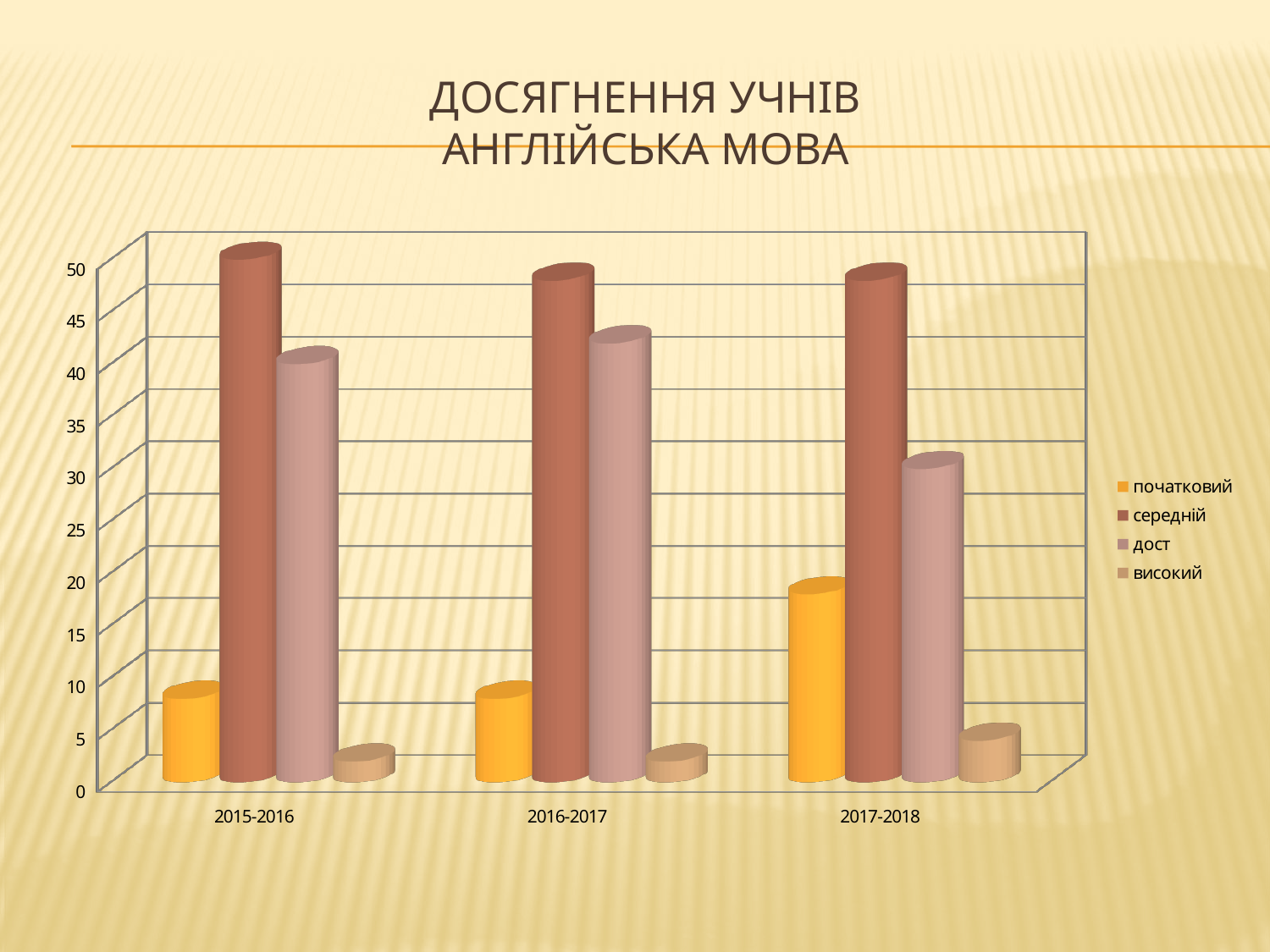
Is the value for середній in 2015-2016 greater or less than 45? greater Is the value for дост in 2017-2018 greater or less than 35? less Which series has the highest value in 2015-2016? середній How many school-year categories are shown on the x axis? 3 Which is larger: the value for дост in 2016-2017 or in 2017-2018? 2016-2017 Is the value for високий in 2015-2016 greater or less than 5? less What kind of chart is shown on the slide? bar chart Which is larger: the value for початковий in 2015-2016 or in 2017-2018? 2017-2018 Which series has the lowest value in 2017-2018? високий What is the title of the chart on the slide? ДОСЯГНЕННЯ УЧНІВ АНГЛІЙСЬКА МОВА How many series does the legend list? 4